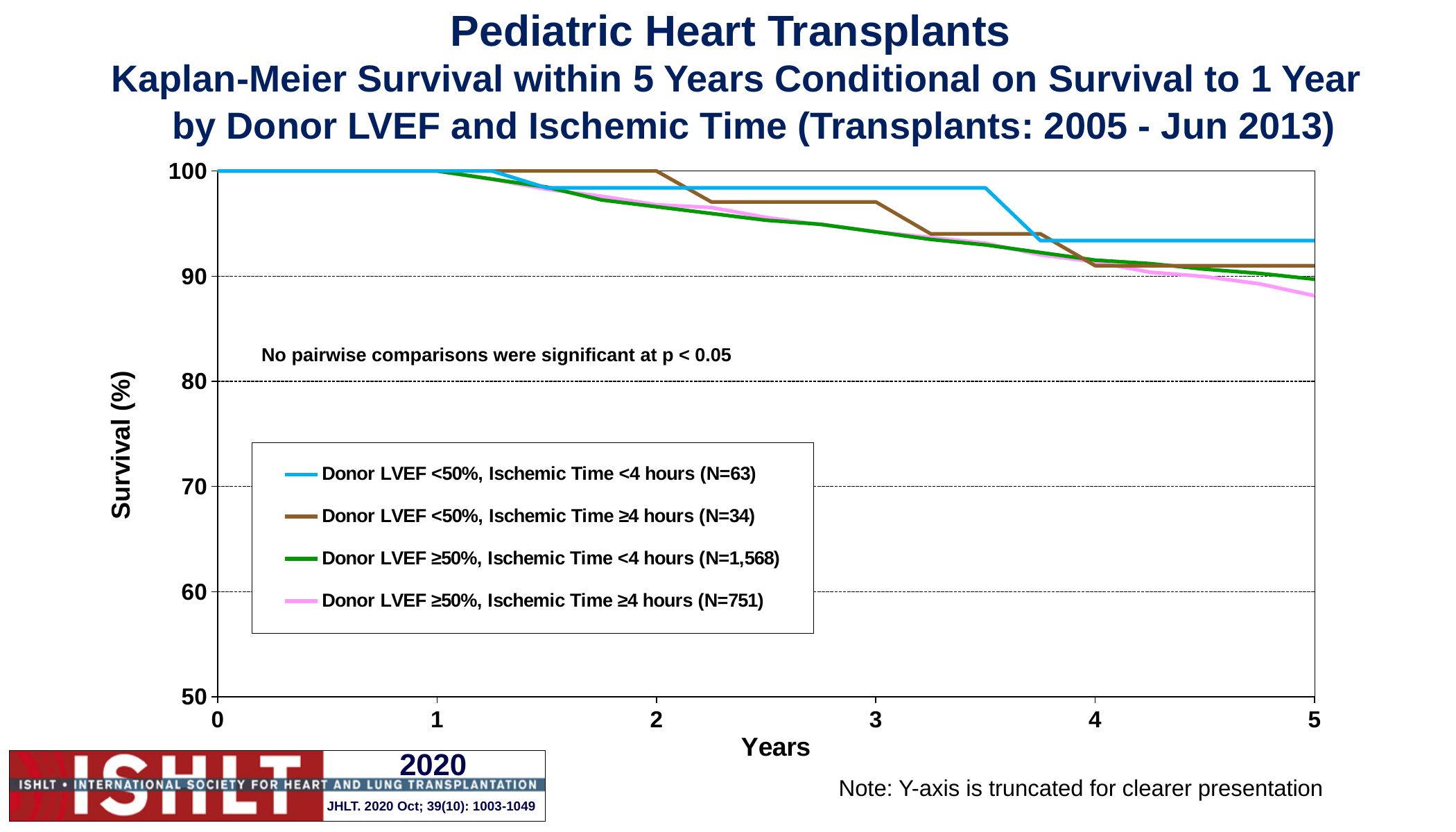
How many series does the legend list? 4 At 5 years, which has higher survival: Donor LVEF <50%, Ischemic Time <4 hours or Donor LVEF ≥50%, Ischemic Time ≥4 hours? Donor LVEF <50%, Ischemic Time <4 hours At 5 years, which series has the highest survival? Donor LVEF <50%, Ischemic Time <4 hours (N=63) At 3 years, is the survival value for Donor LVEF ≥50%, Ischemic Time <4 hours greater or less than 90? greater At 5 years, is the survival value for Donor LVEF ≥50%, Ischemic Time ≥4 hours greater or less than 90? less At 5 years, is the survival value for Donor LVEF <50%, Ischemic Time <4 hours greater or less than 90? greater What is the N for the Donor LVEF ≥50%, Ischemic Time <4 hours series? N=1,568 What kind of chart is shown on the slide? Line chart Do the survival curves rise or fall as the years increase? Fall What colour is the line for Donor LVEF <50%, Ischemic Time ≥4 hours (N=34)? Brown